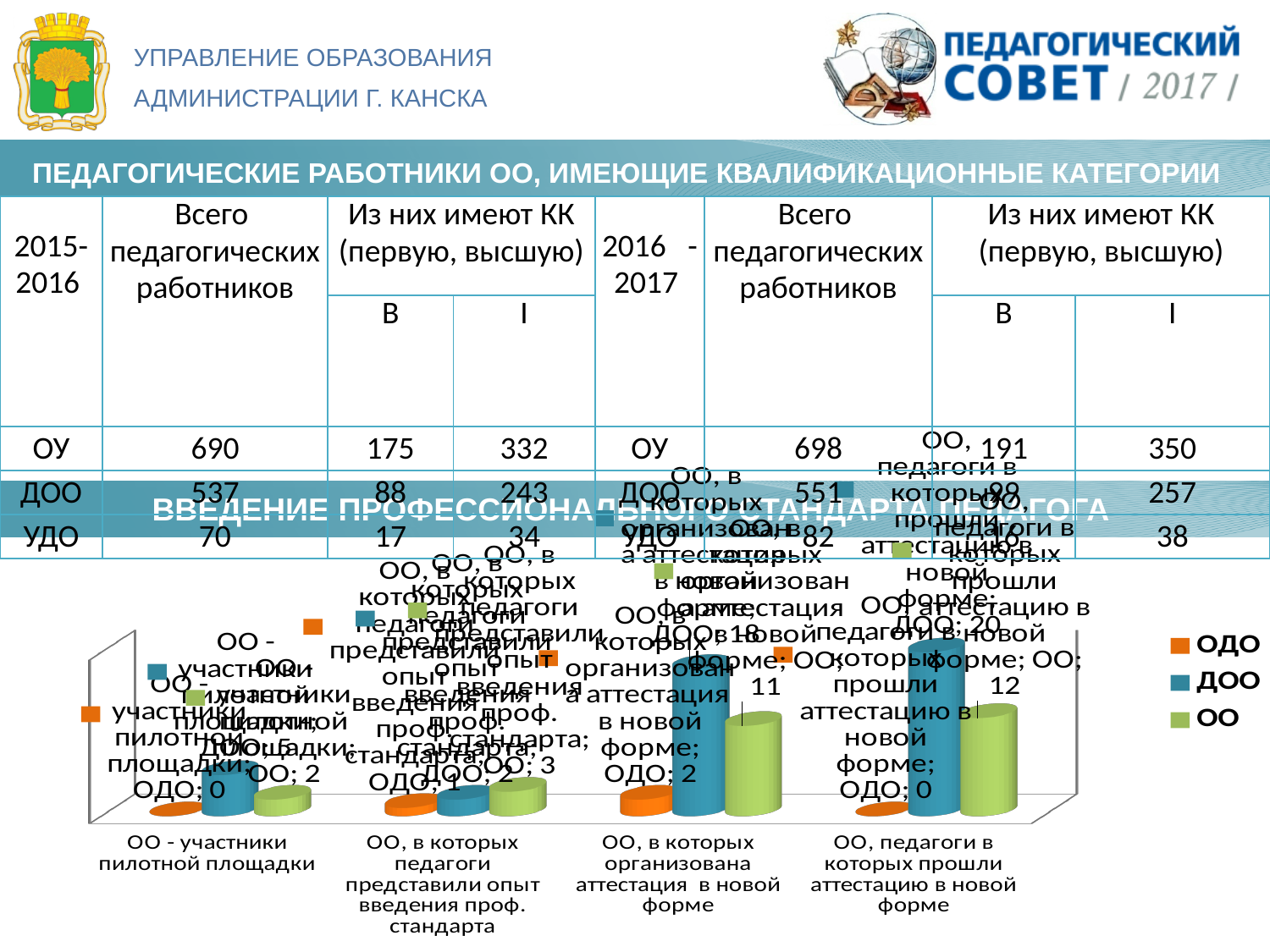
How many series does the chart legend list? 3 How many categories are shown along the x axis of the chart? 4 In the category 'ОО, педагоги в которых прошли аттестацию в новой форме', which is larger: ДОО or ОО? ДОО What is the value for ДОО in the category 'ОО, в которых организована аттестация в новой форме'? 18 Which series are listed in the chart legend? ОДО, ДОО, ОО What is the value for ОО in the category 'ОО, педагоги в которых прошли аттестацию в новой форме'? 12 What is the value for ДОО in the category 'ОО, педагоги в которых прошли аттестацию в новой форме'? 20 What is the difference between ДОО and ОО in the category 'ОО, педагоги в которых прошли аттестацию в новой форме'? 8 What kind of chart is shown on the slide? bar chart In which category does the ДОО series reach its highest value? ОО, педагоги в которых прошли аттестацию в новой форме What is the value for ОО in the category 'ОО, в которых организована аттестация в новой форме'? 11 What is the difference between ДОО and ОО in the category 'ОО, в которых организована аттестация в новой форме'? 7